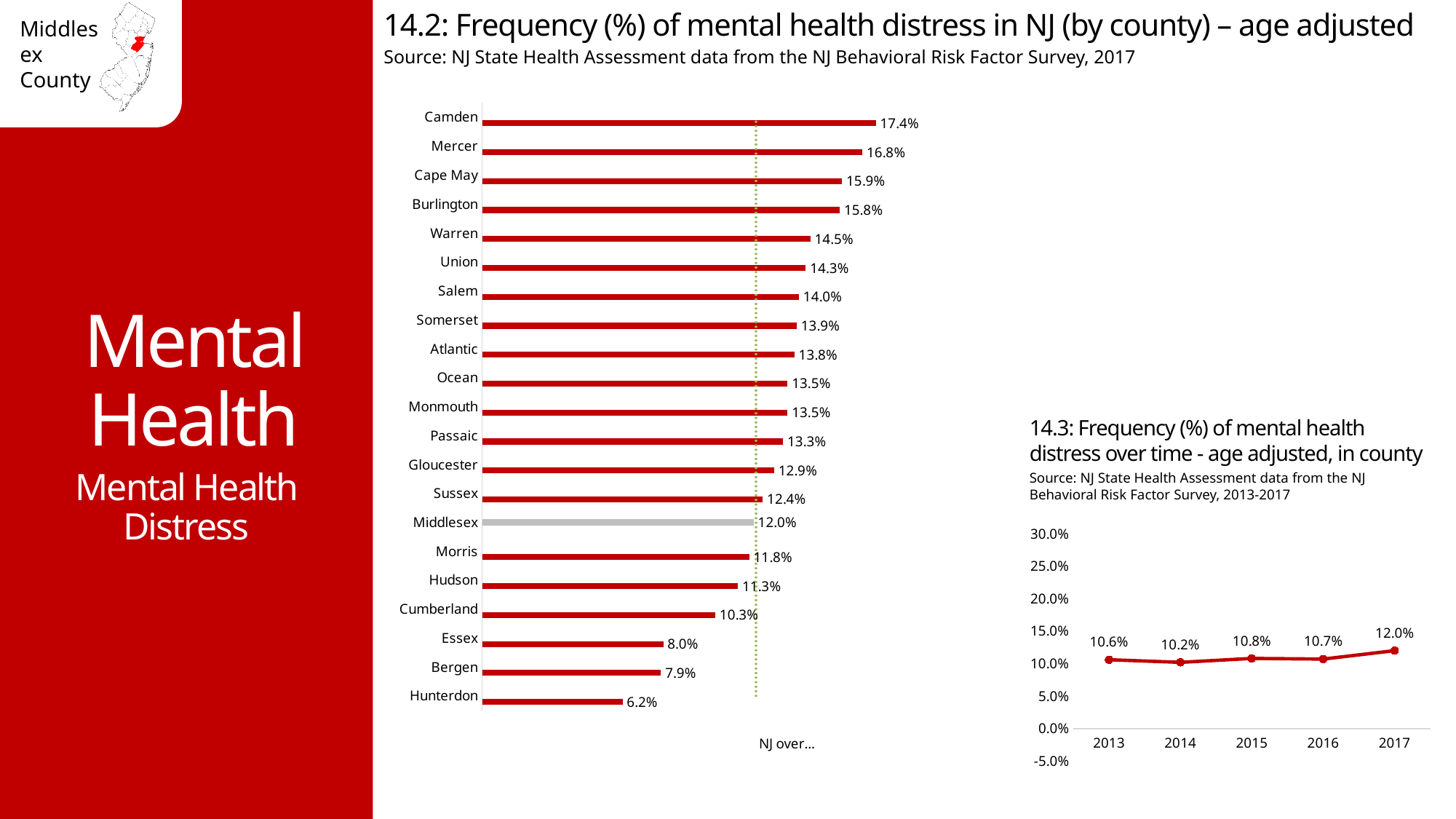
In the chart 14.2 (by county), what is the value for Middlesex? 12.0% In the chart 14.3 (over time), what is the difference between the 2017 and 2013 values? 1.4% In the chart 14.2 (by county), which county has the highest value? Camden What kind of chart is chart 14.2 (by county)? Bar chart In the chart 14.2 (by county), what is the difference between Camden and Hunterdon? 11.2% In the chart 14.2 (by county), which county has the lowest value? Hunterdon In the chart 14.2 (by county), which is larger, the value for Mercer or the value for Warren? Mercer In the chart 14.3 (over time), what is the value for 2014? 10.2% In the chart 14.2 (by county), how many counties are plotted? 21 In the chart 14.2 (by county), what is the value for Cumberland? 10.3% In the chart 14.3 (over time), which year has the highest value? 2017 What kind of chart is chart 14.3 (over time)? Line chart